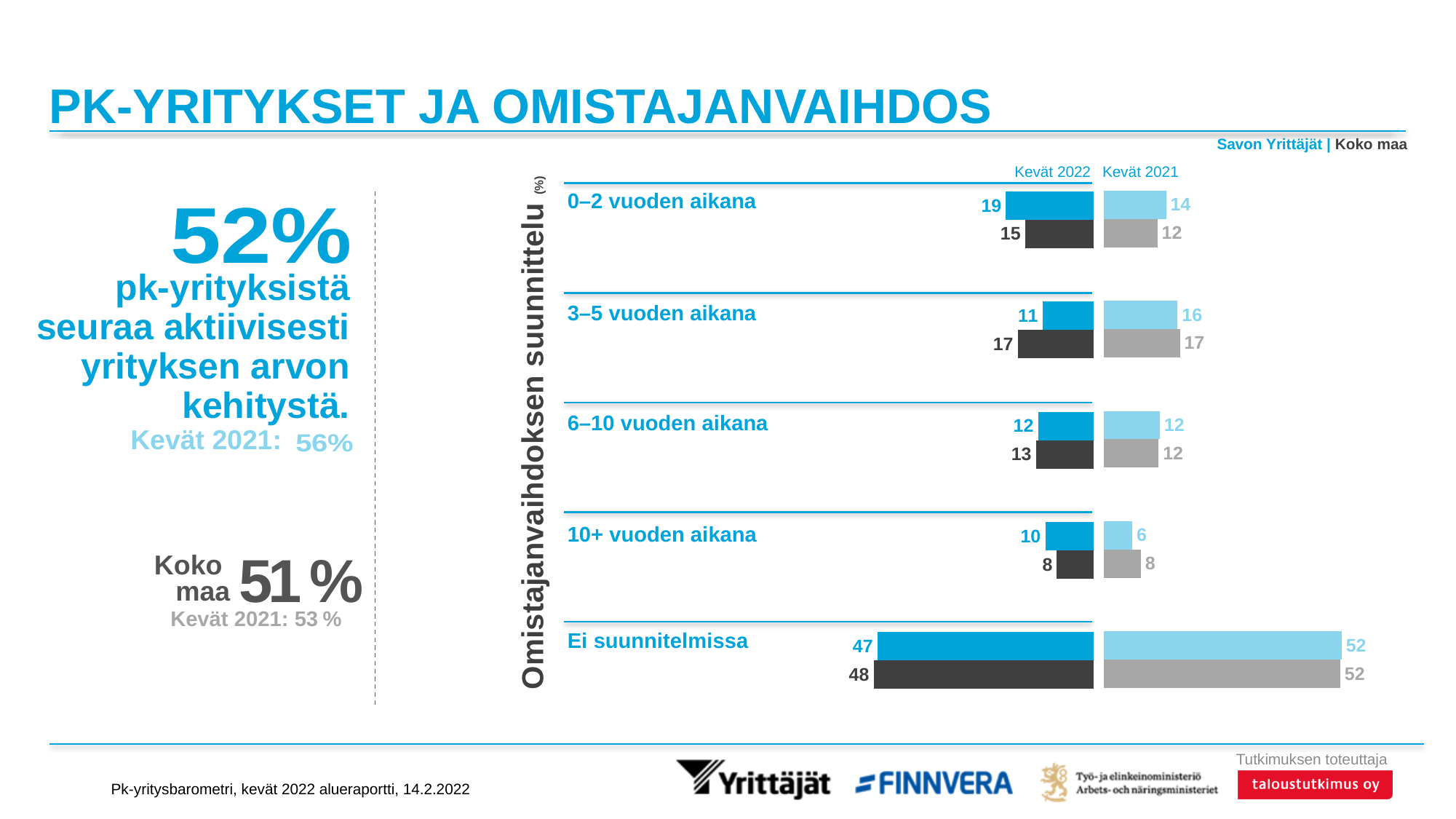
What is the difference between the Savon Yrittäjät Kevät 2022 and Koko maa Kevät 2022 values for "0–2 vuoden aikana"? 4 How many categories does the chart show? 5 What kind of chart is shown on the slide? Bar chart What is the Koko maa Kevät 2022 value for "3–5 vuoden aikana"? 17 What is the Savon Yrittäjät Kevät 2021 value for "10+ vuoden aikana"? 6 Which category has the highest Savon Yrittäjät Kevät 2022 value? Ei suunnitelmissa What is the difference between the Savon Yrittäjät Kevät 2021 and Savon Yrittäjät Kevät 2022 values for "Ei suunnitelmissa"? 5 What is the Savon Yrittäjät Kevät 2022 value for "0–2 vuoden aikana"? 19 Which category has the lowest Savon Yrittäjät Kevät 2021 value? 10+ vuoden aikana What is the axis title of the chart? Omistajanvaihdoksen suunnittelu (%) For "3–5 vuoden aikana", which is larger: the Savon Yrittäjät Kevät 2022 value or the Savon Yrittäjät Kevät 2021 value? Savon Yrittäjät Kevät 2021 What is the Koko maa Kevät 2021 value for "Ei suunnitelmissa"? 52